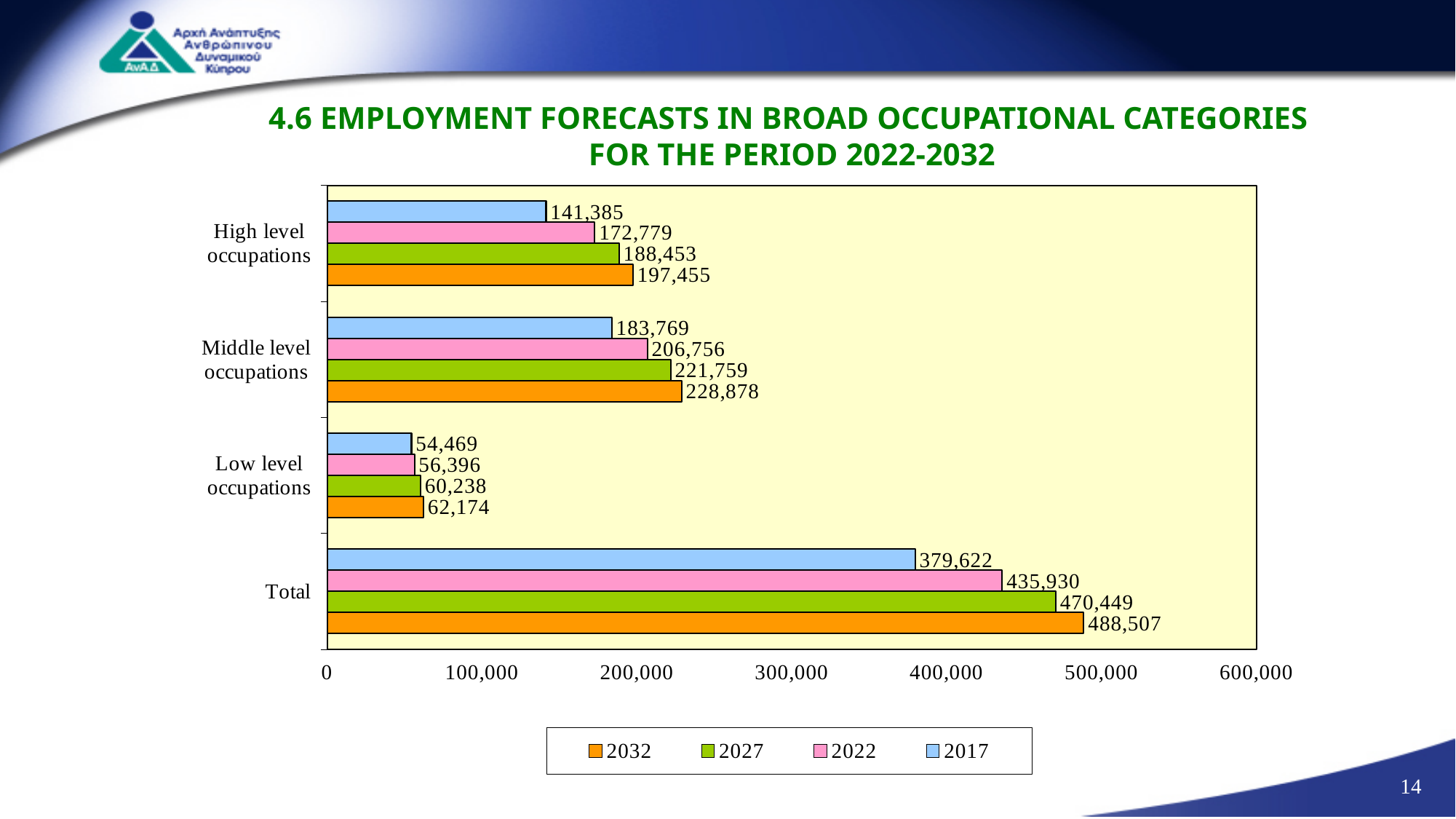
What is the value for Middle level occupations in 2017? 183,769 Which is larger: the 2022 value for Middle level occupations or the 2032 value for High level occupations? 2022 value for Middle level occupations What kind of chart is shown on the slide? Bar chart What is the Total value for 2027? 470,449 What is the value for Low level occupations in 2022? 56,396 How many series does the legend list? 4 What is the difference between the 2032 and 2017 values for High level occupations? 56,070 Excluding Total, which occupational category has the highest value in 2032? Middle level occupations Do the values for Middle level occupations rise or fall from 2017 to 2032? Rise What is the value for High level occupations in 2032? 197,455 What is the difference between the Total values for 2032 and 2017? 108,885 Which occupational category has the lowest value in 2017? Low level occupations